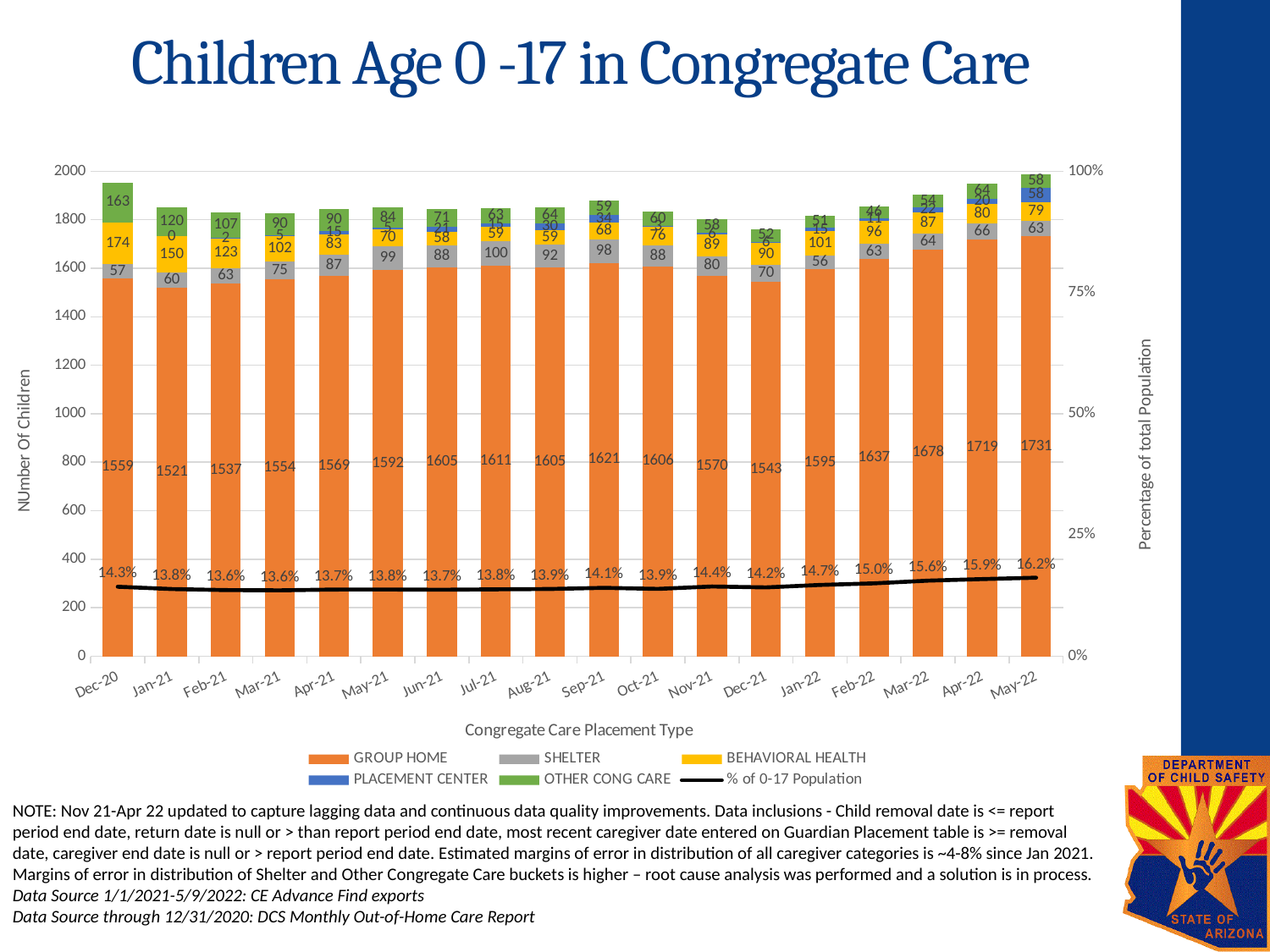
Does the % of 0-17 Population line rise or fall overall from Dec-20 to May-22? rise Which month has the lowest GROUP HOME value? Jan-21 What is the BEHAVIORAL HEALTH value for Dec-20? 174 What is the GROUP HOME value for May-22? 1731 How many months are shown on the x axis? 18 Which month has the highest GROUP HOME value? May-22 What is the SHELTER value for Jul-21? 100 What is the % of 0-17 Population value for Mar-22? 15.6% What is the difference between the GROUP HOME values for May-22 and Dec-20? 172 Which is larger, the SHELTER value for Apr-21 or for Jan-22? Apr-21 How many series does the legend list? 6 Which month has the highest % of 0-17 Population value? May-22